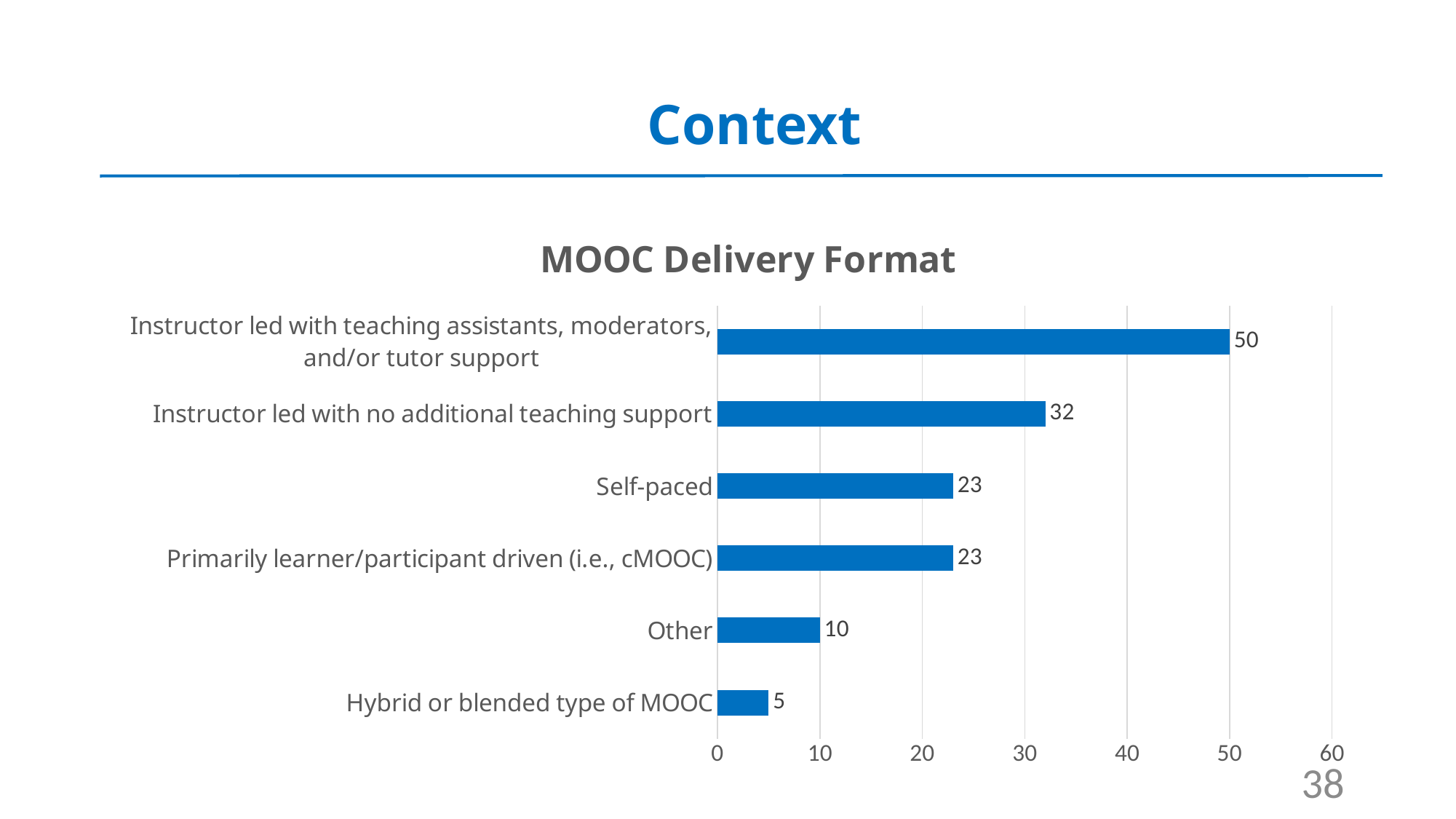
What is the difference between the values for "Instructor led with teaching assistants, moderators, and/or tutor support" and "Instructor led with no additional teaching support"? 18 What kind of chart is shown on the slide? Bar chart How many categories are shown in the chart? 6 What is the value for "Hybrid or blended type of MOOC"? 5 Which category has the highest value? Instructor led with teaching assistants, moderators, and/or tutor support Which is larger, the value for "Self-paced" or the value for "Other"? Self-paced What is the title of the chart? MOOC Delivery Format What is the value for "Instructor led with no additional teaching support"? 32 What is the value for "Self-paced"? 23 Which category has the lowest value? Hybrid or blended type of MOOC What is the value for "Instructor led with teaching assistants, moderators, and/or tutor support"? 50 What is the difference between the values for "Other" and "Hybrid or blended type of MOOC"? 5